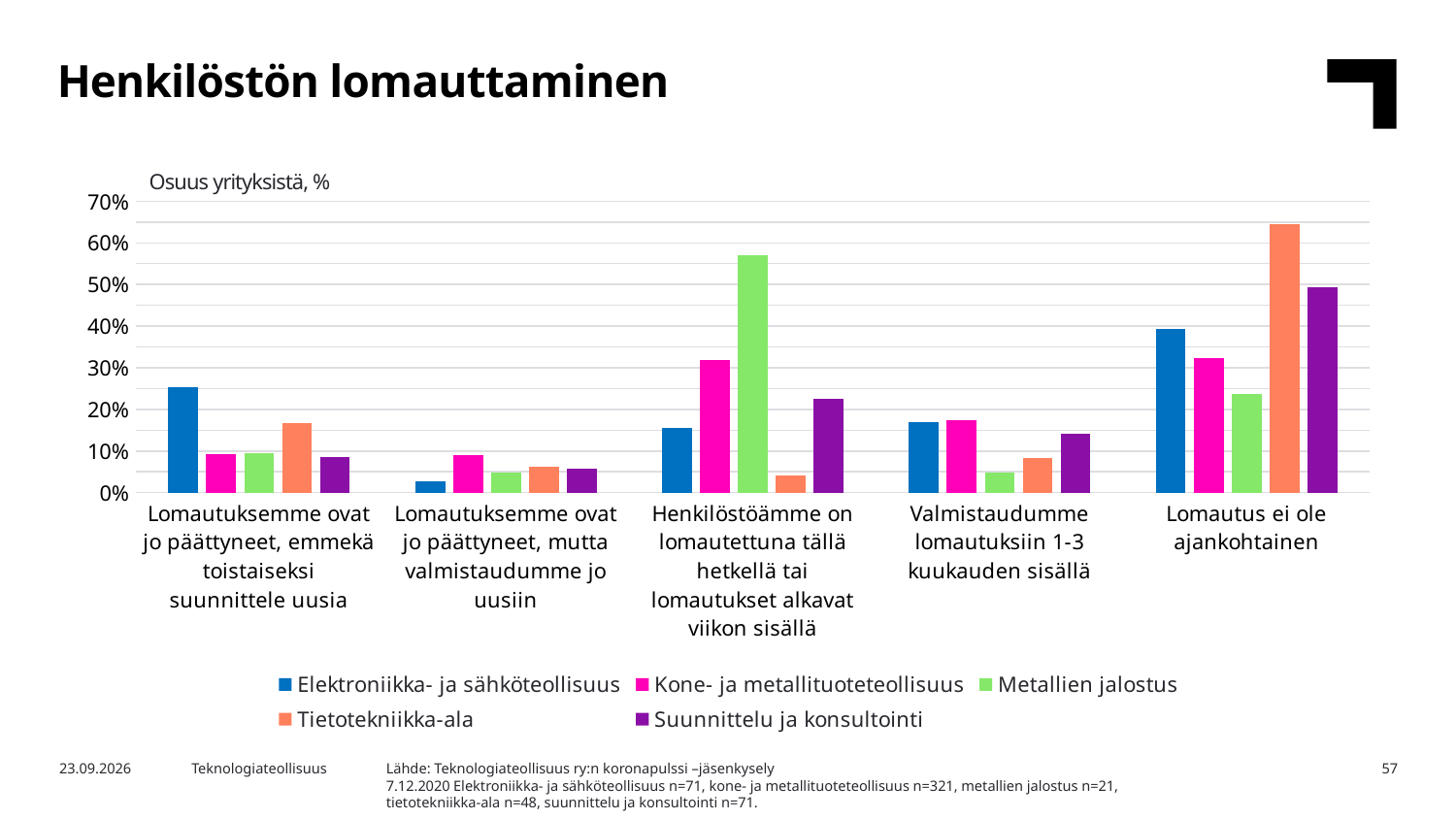
Which series has the highest value in the category 'Lomautus ei ole ajankohtainen'? Tietotekniikka-ala How many series does the legend list? 5 What is the label shown above the vertical axis of the chart? Osuus yrityksistä, % Which series has the highest value in the category 'Henkilöstöämme on lomautettuna tällä hetkellä tai lomautukset alkavat viikon sisällä'? Metallien jalostus Is the value for Elektroniikka- ja sähköteollisuus in the category 'Lomautuksemme ovat jo päättyneet, mutta valmistaudumme jo uusiin' greater or less than 10%? less What kind of chart is shown on the slide? Bar chart Is the value for Metallien jalostus in the category 'Henkilöstöämme on lomautettuna tällä hetkellä tai lomautukset alkavat viikon sisällä' greater or less than 50%? greater Which series has the lowest value in the category 'Henkilöstöämme on lomautettuna tällä hetkellä tai lomautukset alkavat viikon sisällä'? Tietotekniikka-ala In the category 'Lomautuksemme ovat jo päättyneet, emmekä toistaiseksi suunnittele uusia', which is larger: Elektroniikka- ja sähköteollisuus or Kone- ja metallituoteteollisuus? Elektroniikka- ja sähköteollisuus For the Elektroniikka- ja sähköteollisuus series, which category has the highest value? Lomautus ei ole ajankohtainen Is the value for Tietotekniikka-ala in the category 'Lomautus ei ole ajankohtainen' greater or less than 60%? greater How many categories are shown along the x axis? 5